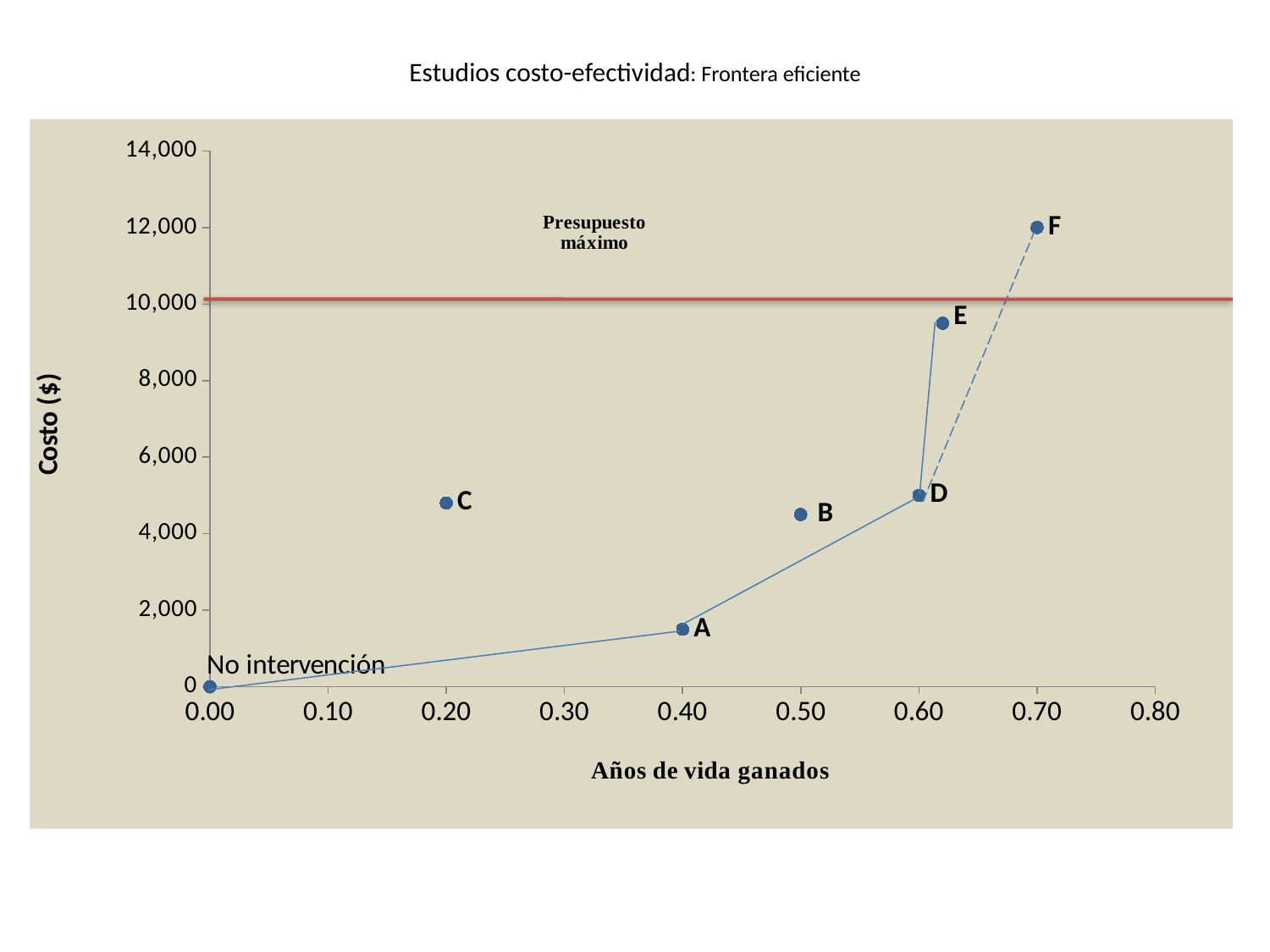
Is the cost for point D greater or less than 6,000? less Which point has the highest cost? F What is the value on the 'Años de vida ganados' axis for point A? 0.40 What kind of chart is shown on the slide? Scatter chart Which point has a higher cost, E or D? E What is the cost ($) for point F? 12,000 Is the cost for point E greater or less than 8,000? greater Is the cost for point A greater or less than 2,000? less What label is given to the horizontal red line on the chart? Presupuesto máximo How many labelled points are plotted on the chart? 7 Which point has the lowest cost? No intervención What is the value on the 'Años de vida ganados' axis for point F? 0.70